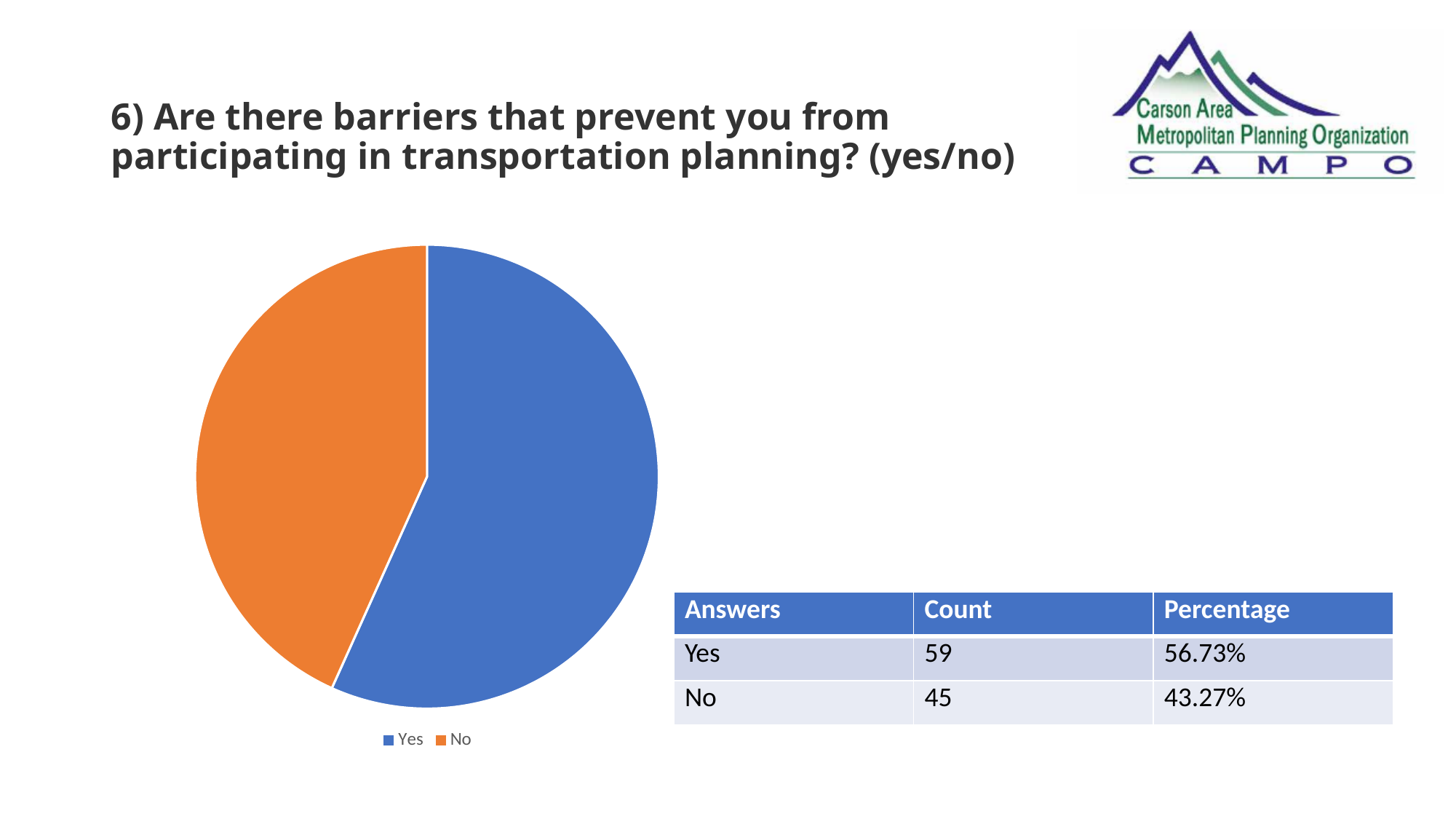
What is the count for Yes? 59 Which answer has the smallest slice in the pie chart? No Which is larger, the count for Yes or the count for No? Yes Which answer has the largest slice in the pie chart? Yes What is the total number of responses shown in the table? 104 What percentage of responses were Yes? 56.73% How many more respondents answered Yes than No? 14 What colour is the Yes slice in the pie chart? blue What percentage of responses were No? 43.27% How many slices does the pie chart have? 2 What is the count for No? 45 What kind of chart is shown on the slide? pie chart